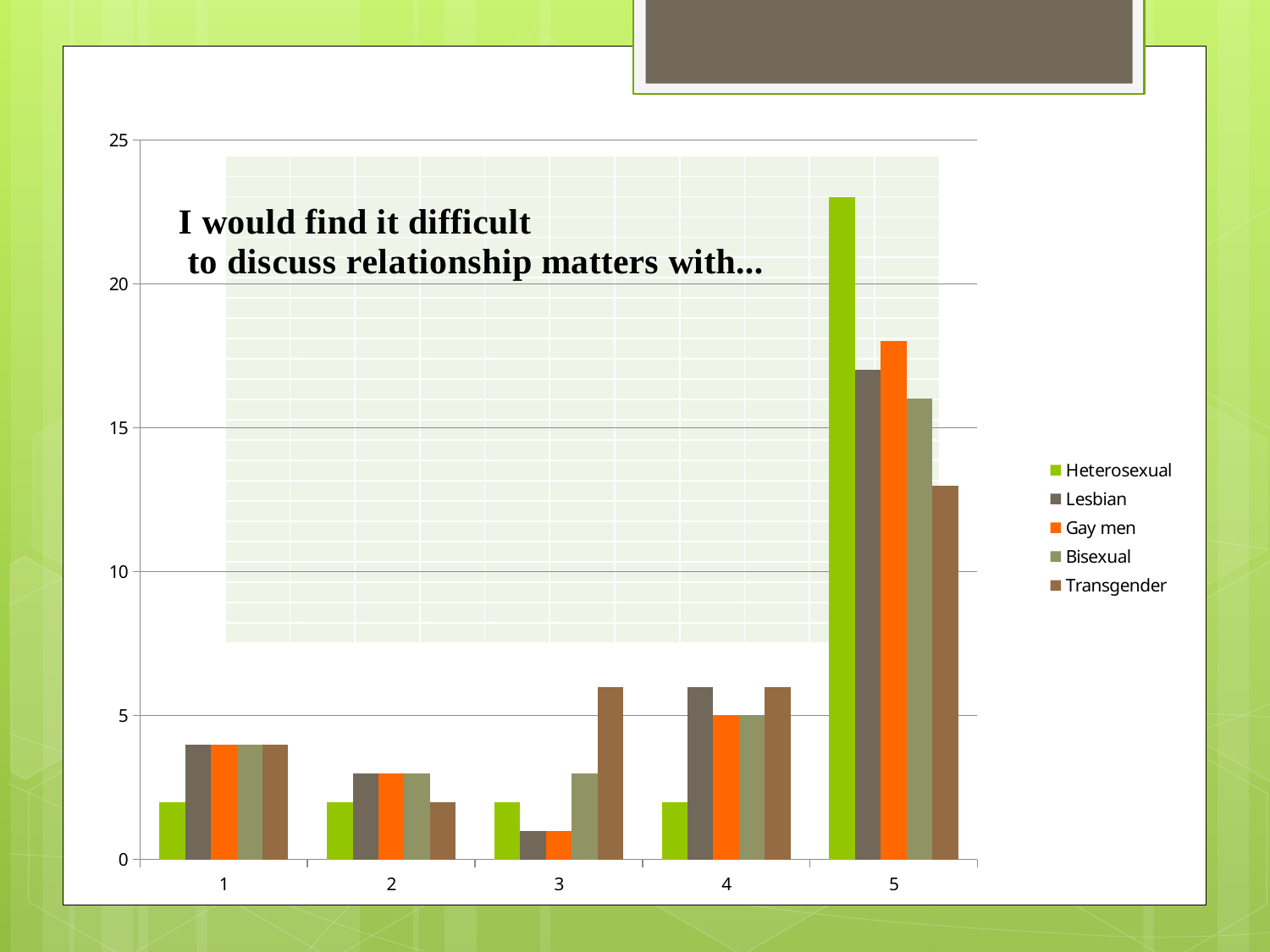
Which series is shown in orange in the legend? Gay men Is the value for Gay men in category 5 greater or less than 15? greater What kind of chart is shown on the slide? bar chart Which series has the lowest bar in category 5? Transgender Is the value for Transgender in category 3 greater or less than 5? greater How many series does the legend list? 5 Is the value for Transgender in category 5 greater or less than 15? less What is the title of the chart? I would find it difficult to discuss relationship matters with... Which series has the highest bar in category 5? Heterosexual In category 3, which is larger: the value for Transgender or the value for Lesbian? Transgender How many categories are shown on the x axis? 5